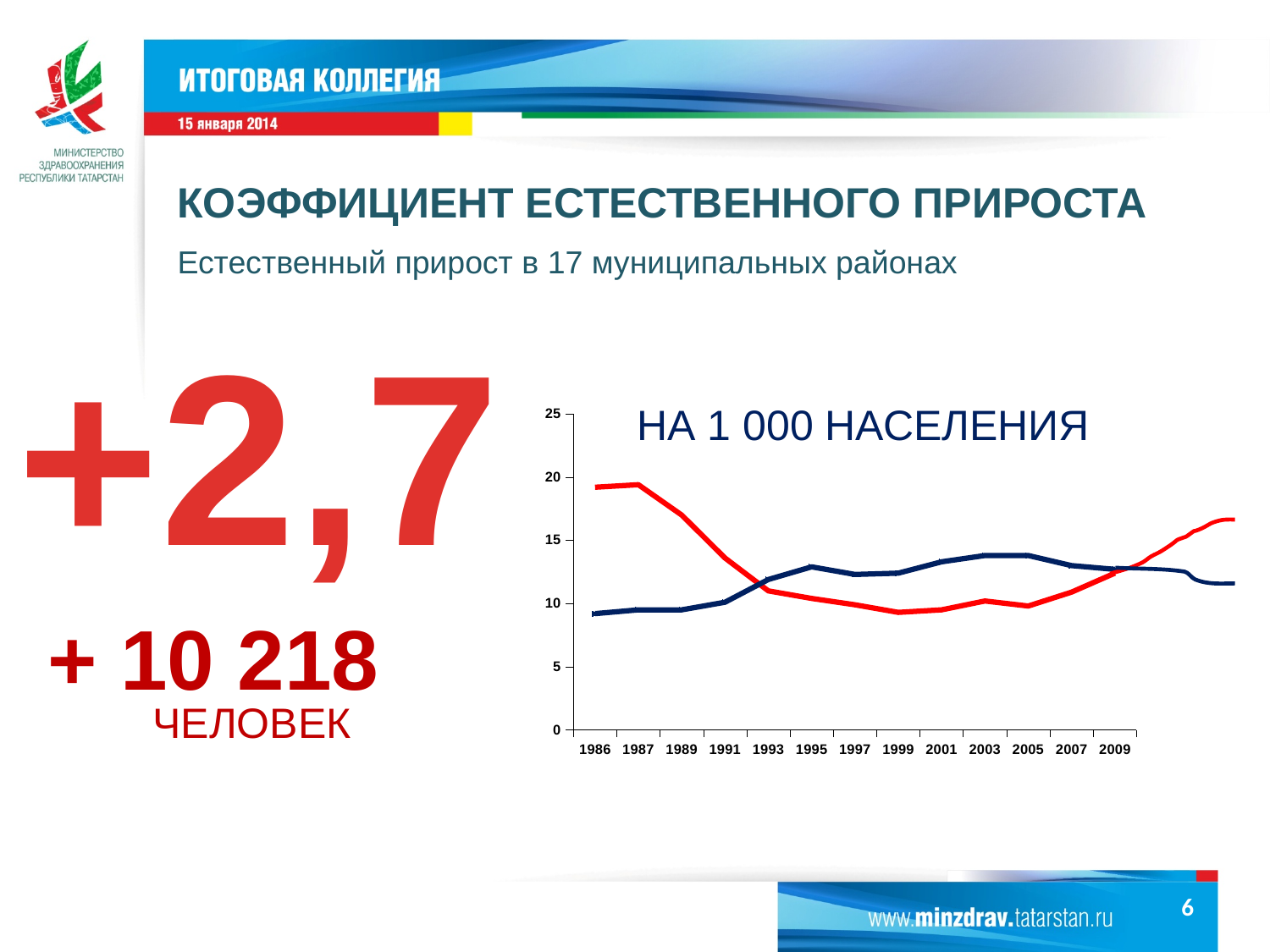
What kind of chart is shown on the slide? line chart Is the value of the red line in 1999 greater or less than 10? less How many year labels are shown on the chart's horizontal axis? 13 Does the red line rise or fall between 1986 and 1999? fall What is the highest value shown on the chart's vertical axis? 25 Is the value of the dark blue line in 1986 greater or less than 10? less Is the value of the dark blue line in 2009 greater or less than 15? less What is the title printed above the chart? НА 1 000 НАСЕЛЕНИЯ In 2003, which line has the higher value, the red line or the dark blue line? the dark blue line How many lines are plotted on the chart? 2 In 1986, which line has the higher value, the red line or the dark blue line? the red line